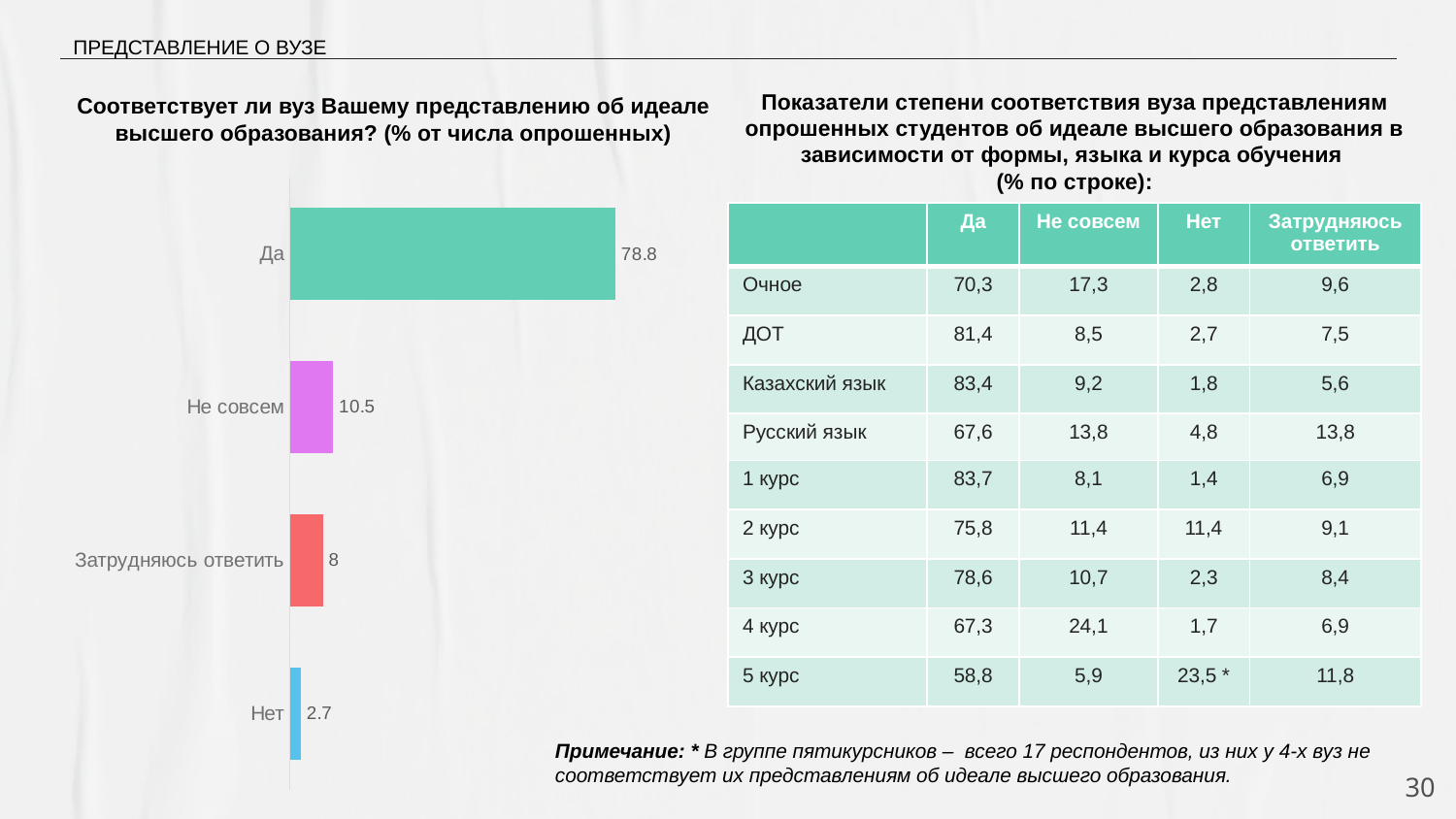
What type of chart is shown on the slide? Bar chart What is the difference between the values for "Не совсем" and "Затрудняюсь ответить" in the bar chart? 2.5 What colour is the bar for "Да" in the bar chart? Green How many categories are shown in the bar chart? 4 What value is shown for "Затрудняюсь ответить" in the bar chart? 8 What value is shown for "Не совсем" in the bar chart? 10.5 What value is shown for "Да" in the bar chart? 78.8 What value is shown for "Нет" in the bar chart? 2.7 What is the difference between the values for "Да" and "Не совсем" in the bar chart? 68.3 Which is larger in the bar chart: the value for "Затрудняюсь ответить" or the value for "Нет"? Затрудняюсь ответить Which category has the lowest value in the bar chart? Нет Which category has the highest value in the bar chart? Да